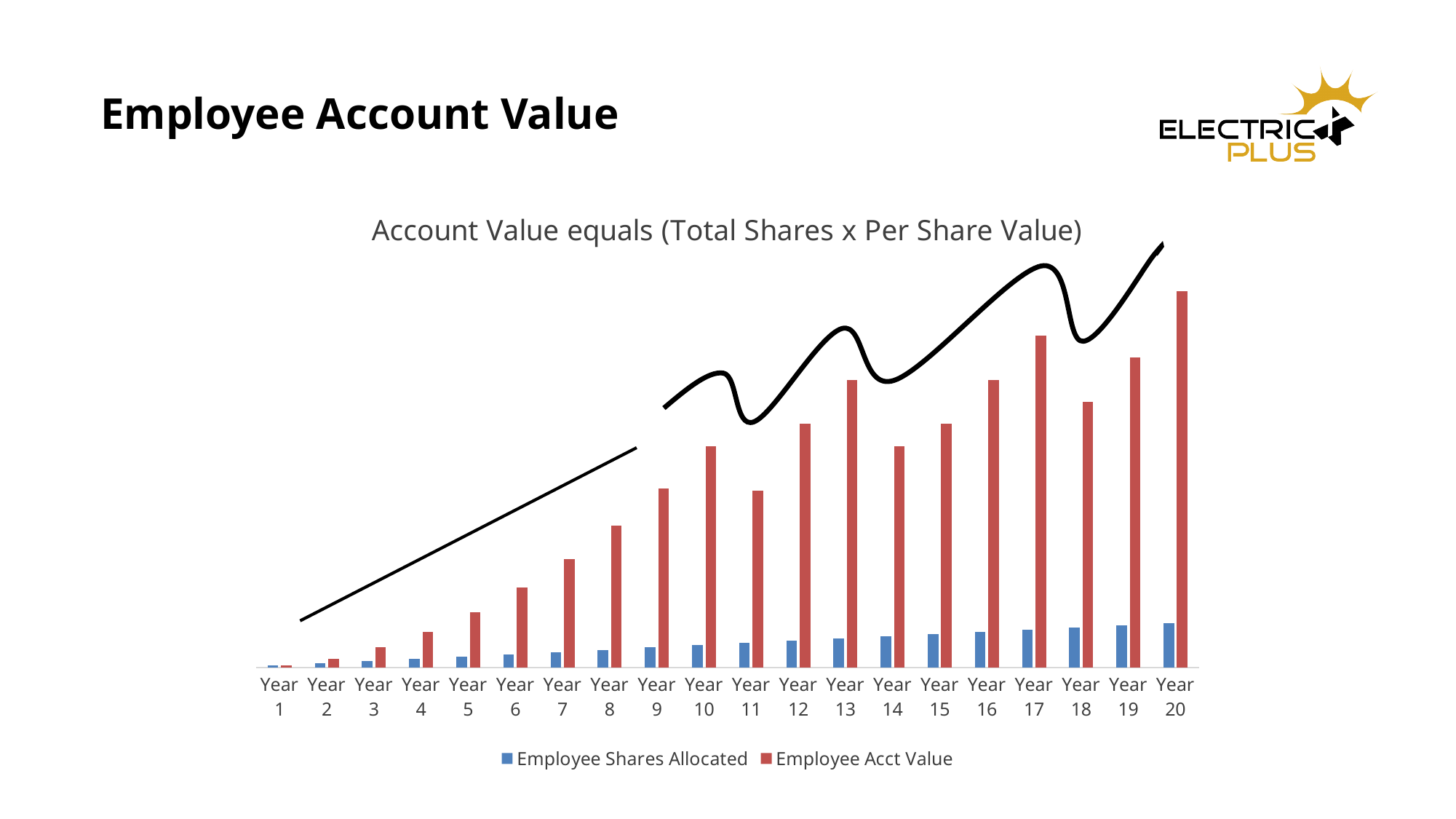
What is the title of the chart? Account Value equals (Total Shares x Per Share Value) Is the Employee Acct Value larger in Year 17 or Year 18? Year 17 Which year has the highest Employee Shares Allocated? Year 20 Is the Employee Acct Value larger in Year 13 or Year 14? Year 13 Does the Employee Shares Allocated series rise or fall from Year 1 to Year 20? Rise How many years (categories) are shown on the x axis? 20 Which year has the lowest Employee Acct Value? Year 1 Is the Employee Acct Value larger in Year 10 or Year 11? Year 10 Which year has the highest Employee Acct Value? Year 20 How many series does the legend list? 2 Which series is shown in red? Employee Acct Value What kind of chart is shown on the slide? Bar chart